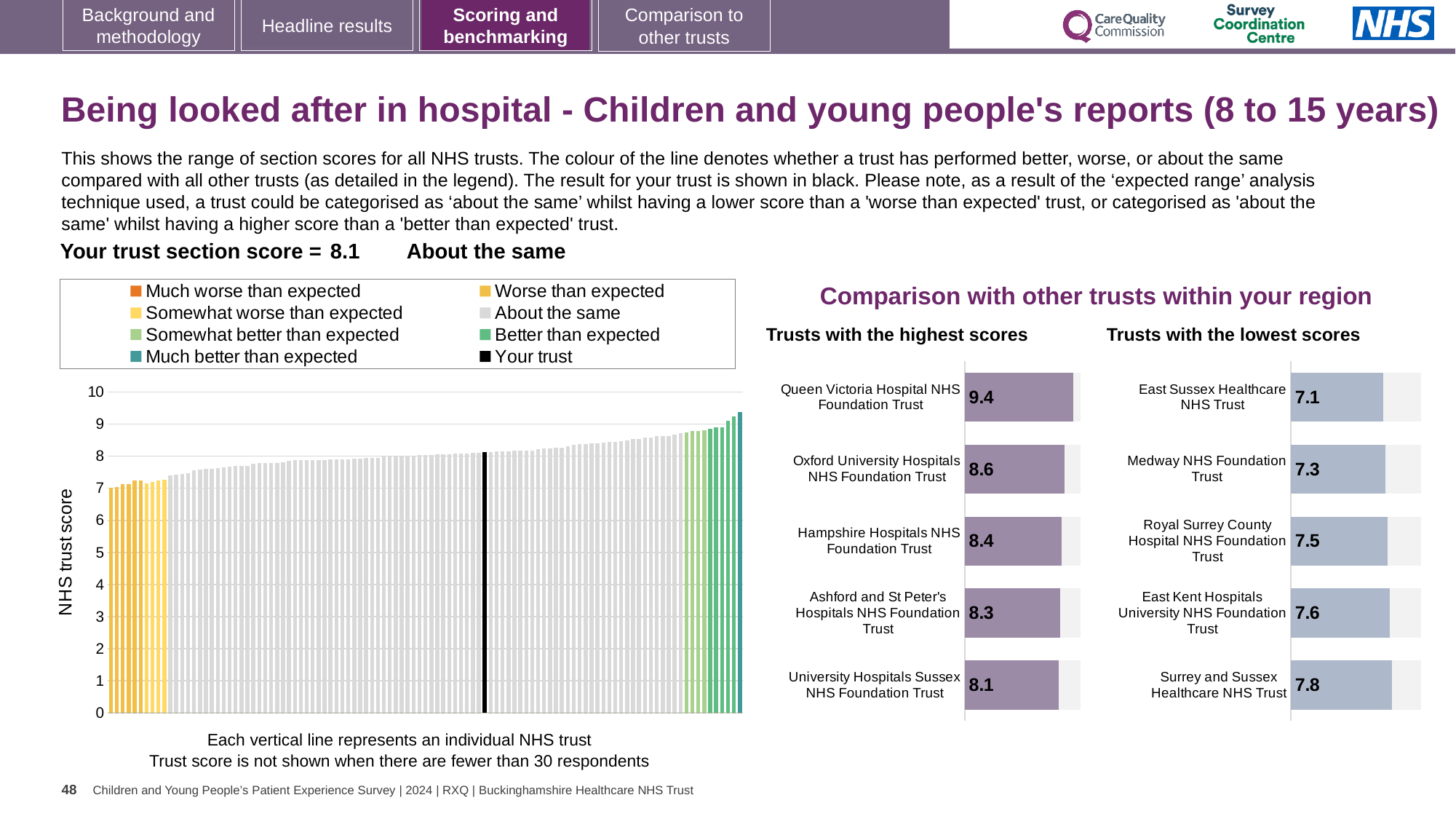
In the 'Trusts with the highest scores' chart, what is the difference between the scores of Queen Victoria Hospital NHS Foundation Trust and Oxford University Hospitals NHS Foundation Trust? 0.8 In the 'NHS trust score' chart on the left, is the value of the leftmost bar greater or less than 6? greater In the 'NHS trust score' chart on the left, do the values rise or fall from left to right? Rise How many trusts are listed in the 'Trusts with the highest scores' chart? 5 In the 'Trusts with the lowest scores' chart, which trust has the lowest score? East Sussex Healthcare NHS Trust In the 'Trusts with the lowest scores' chart, what is the score for Medway NHS Foundation Trust? 7.3 In the 'Trusts with the highest scores' chart, which trust has the lowest score shown? University Hospitals Sussex NHS Foundation Trust In the 'Trusts with the highest scores' chart, what is the score for Queen Victoria Hospital NHS Foundation Trust? 9.4 In the 'Trusts with the lowest scores' chart, what is the difference between the scores of Surrey and Sussex Healthcare NHS Trust and East Sussex Healthcare NHS Trust? 0.7 What kind of chart is the 'NHS trust score' chart on the left? Bar chart How many entries does the legend of the 'NHS trust score' chart on the left list? 8 In the 'Trusts with the lowest scores' chart, which has the higher score: Royal Surrey County Hospital NHS Foundation Trust or East Kent Hospitals University NHS Foundation Trust? East Kent Hospitals University NHS Foundation Trust